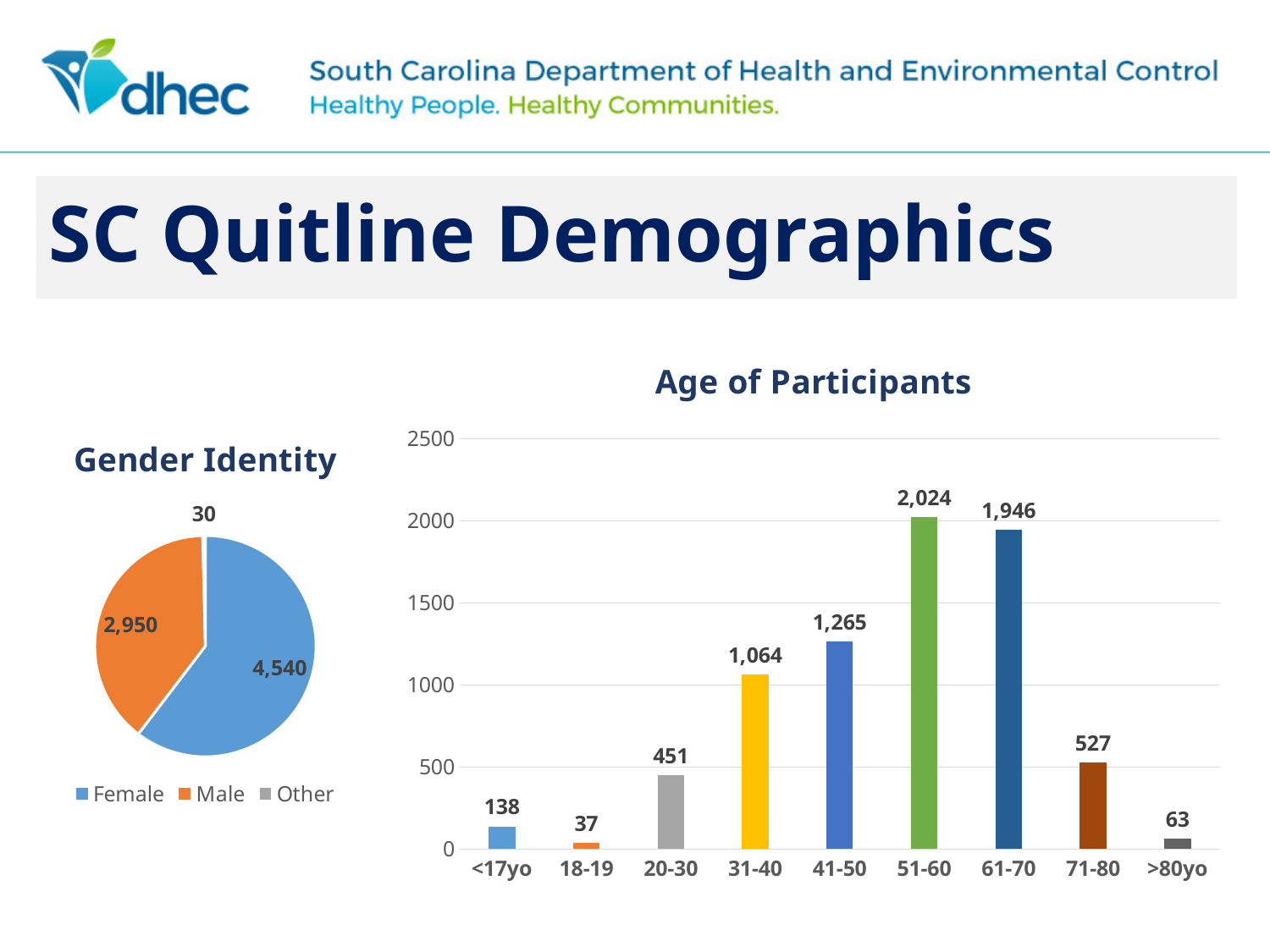
In the Age of Participants chart, which age group has the lowest number of participants? 18-19 In the Gender Identity chart, what is the difference between the Female and Male counts? 1,590 In the Age of Participants chart, how many participants are in the 51-60 age group? 2,024 How many age groups are shown in the Age of Participants chart? 9 In the Age of Participants chart, which has more participants, the 20-30 group or the 71-80 group? 71-80 How many categories does the legend of the Gender Identity chart list? 3 In the Gender Identity chart, what is the total number of participants across all three categories? 7,520 In the Age of Participants chart, how many participants are in the 18-19 age group? 37 In the Age of Participants chart, which age group has the highest number of participants? 51-60 In the Gender Identity chart, how many participants identified as Female? 4,540 What kind of chart is the Age of Participants chart? Bar chart In the Age of Participants chart, what is the difference between the 51-60 and 61-70 age groups? 78